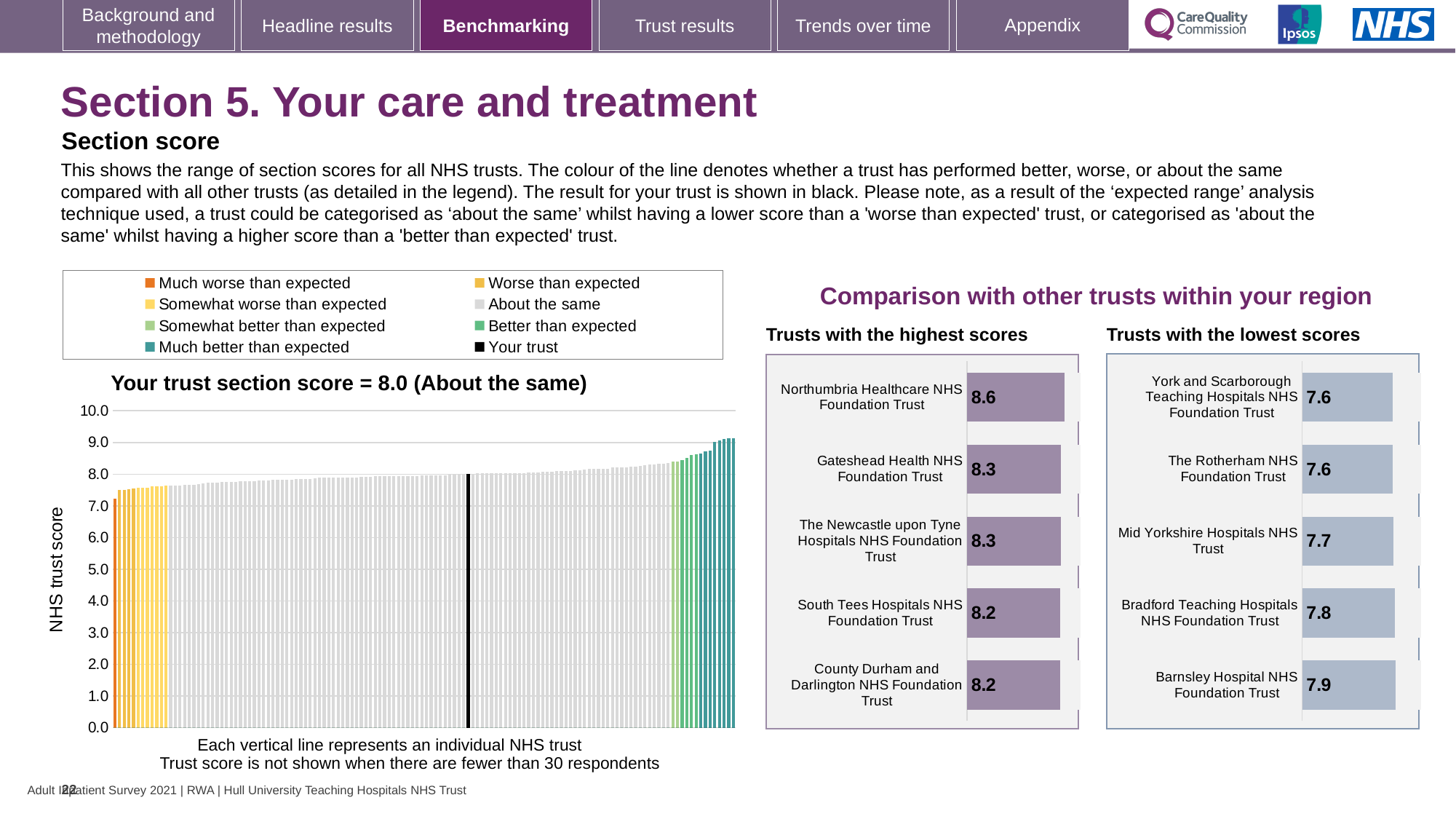
In the 'Trusts with the lowest scores' chart, which trust has the highest score? Barnsley Hospital NHS Foundation Trust What kind of chart is the 'Your trust section score' chart? bar chart In the 'Trusts with the lowest scores' chart, what is the score for Mid Yorkshire Hospitals NHS Trust? 7.7 How many entries does the legend above the 'Your trust section score' chart list? 8 In the 'Trusts with the highest scores' chart, what is the difference between the scores of Northumbria Healthcare NHS Foundation Trust and County Durham and Darlington NHS Foundation Trust? 0.4 In the 'Your trust section score' chart, do the trust scores rise or fall from left to right along the x axis? rise In the 'Trusts with the highest scores' chart, how many trusts are shown? 5 In the 'Your trust section score' chart, is the value of the leftmost (orange) bar greater or less than 8.0? less In the 'Your trust section score' chart, what is the section score for your trust? 8.0 In the 'Trusts with the highest scores' chart, what is the score for Northumbria Healthcare NHS Foundation Trust? 8.6 In the 'Trusts with the lowest scores' chart, which has the larger score: Bradford Teaching Hospitals NHS Foundation Trust or The Rotherham NHS Foundation Trust? Bradford Teaching Hospitals NHS Foundation Trust In the 'Trusts with the highest scores' chart, which trust has the highest score? Northumbria Healthcare NHS Foundation Trust